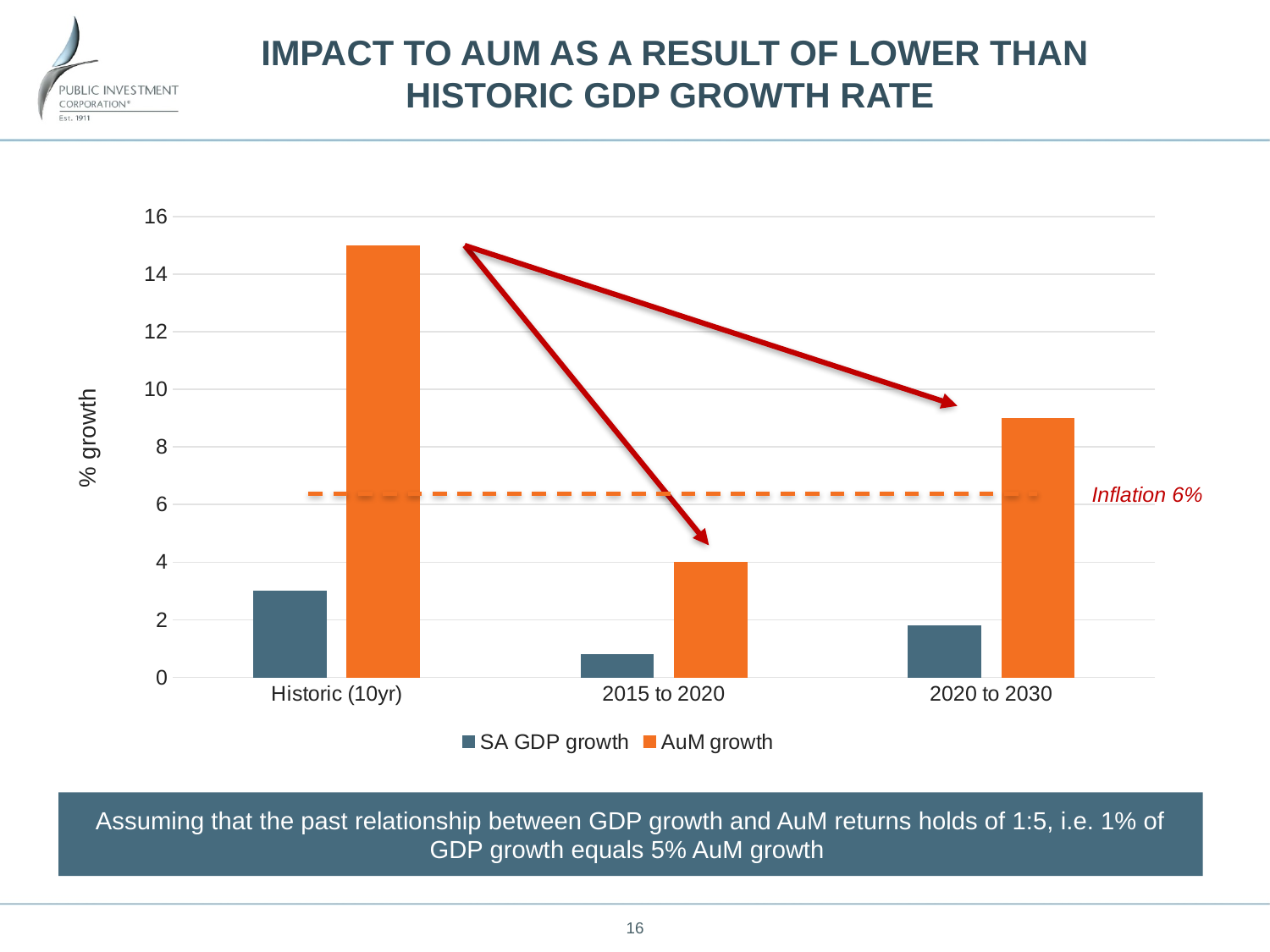
Which is larger: AuM growth for Historic (10yr) or AuM growth for 2020 to 2030? Historic (10yr) Which category has the lowest SA GDP growth? 2015 to 2020 Is the AuM growth value for Historic (10yr) greater or less than 14? greater How many categories are shown on the x axis? 3 Is the AuM growth value for 2020 to 2030 greater or less than 10? less How many series does the legend list? 2 What does the dashed horizontal line on the chart represent? Inflation 6% Which category has the highest AuM growth? Historic (10yr) What kind of chart is shown on the slide? Bar chart Which category has the lowest AuM growth? 2015 to 2020 What is the AuM growth value for 2015 to 2020? 4